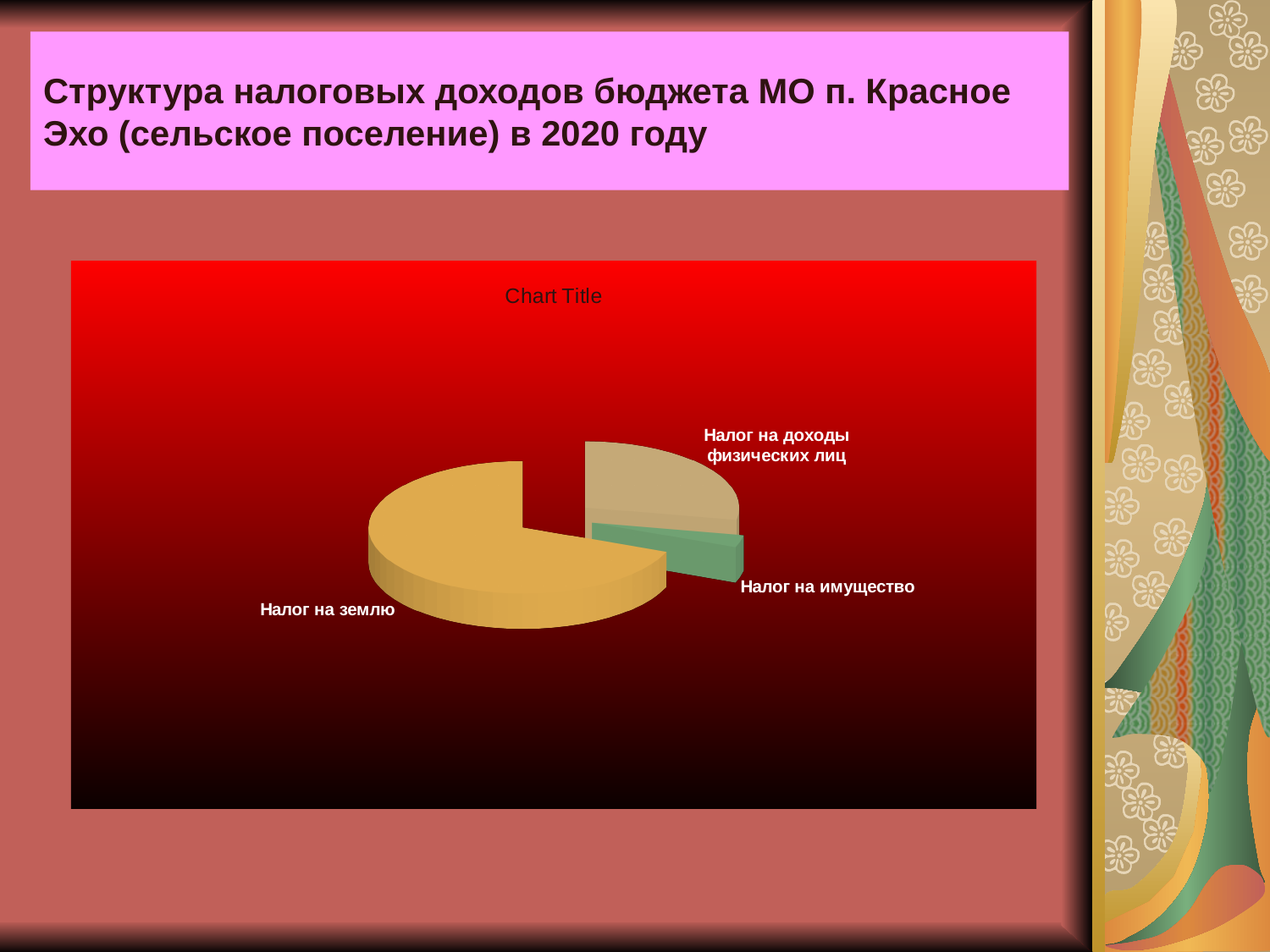
Which slice is larger: Налог на доходы физических лиц or Налог на имущество? Налог на доходы физических лиц What colour is the slice for Налог на имущество? Green Which slice is larger: Налог на землю or Налог на доходы физических лиц? Налог на землю What kind of chart is shown on the slide? Pie chart Which slice is smaller: Налог на землю or Налог на имущество? Налог на имущество How many slices does the pie chart have? 3 What title is printed above the pie chart? Chart Title Which category has the smallest slice of the pie? Налог на имущество Which category has the largest slice of the pie? Налог на землю